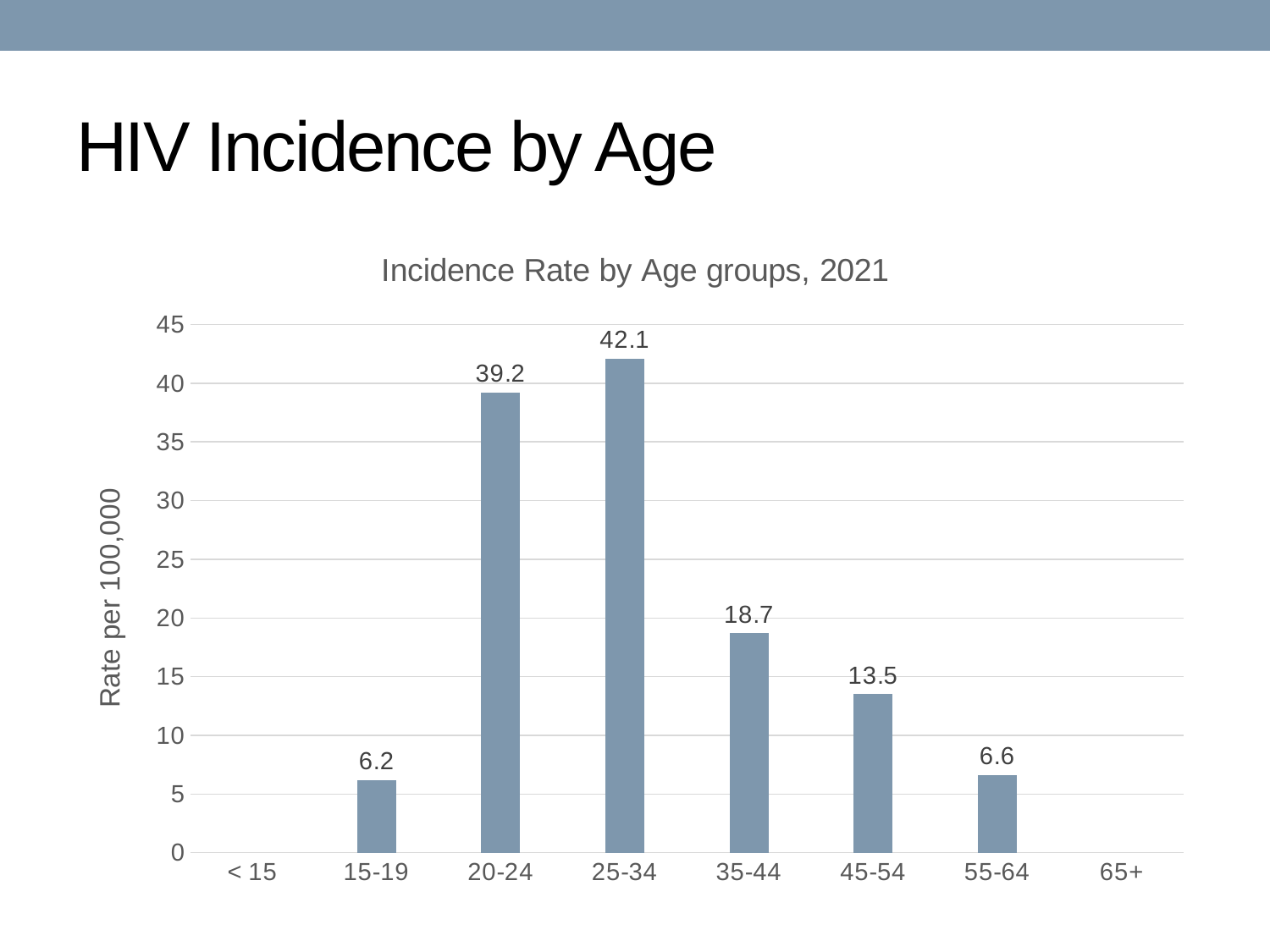
What is the incidence rate for the 15-19 age group? 6.2 Among the age groups with a labelled bar, which has the lowest incidence rate? 15-19 What is the difference between the incidence rates for the 25-34 and 20-24 age groups? 2.9 What is the incidence rate for the 45-54 age group? 13.5 Which age group has the highest incidence rate? 25-34 What is the difference between the incidence rates for the 35-44 and 45-54 age groups? 5.2 What kind of chart is shown on the slide? Bar chart What is the label on the vertical axis of the chart? Rate per 100,000 Which has a higher incidence rate, the 55-64 age group or the 15-19 age group? 55-64 How many age group categories are shown on the x axis? 8 What is the incidence rate for the 25-34 age group? 42.1 Is the value for the 35-44 age group greater or less than 20? less